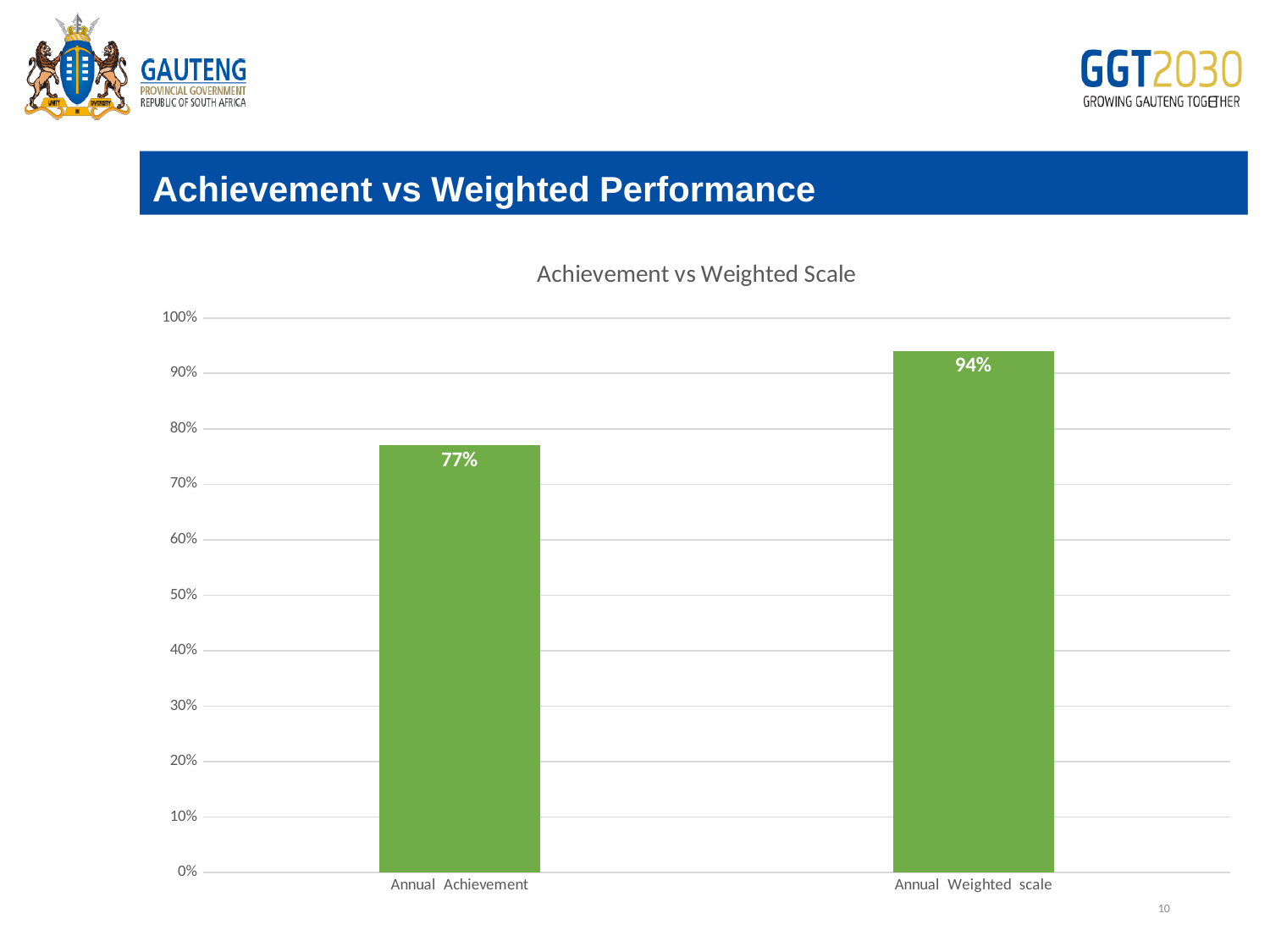
What kind of chart is shown on the slide? Bar chart Which is larger, Annual Achievement or Annual Weighted scale? Annual Weighted scale What is the highest value shown on the vertical axis? 100% What is the value for Annual Weighted scale? 94% How many categories are shown in the chart? 2 Which category has the lowest value? Annual Achievement Is the value for Annual Weighted scale greater or less than 90%? greater What is the value for Annual Achievement? 77% What is the title of the chart? Achievement vs Weighted Scale What is the difference between the Annual Weighted scale value and the Annual Achievement value? 17% Is the value for Annual Achievement greater or less than 80%? less Which category has the highest value? Annual Weighted scale